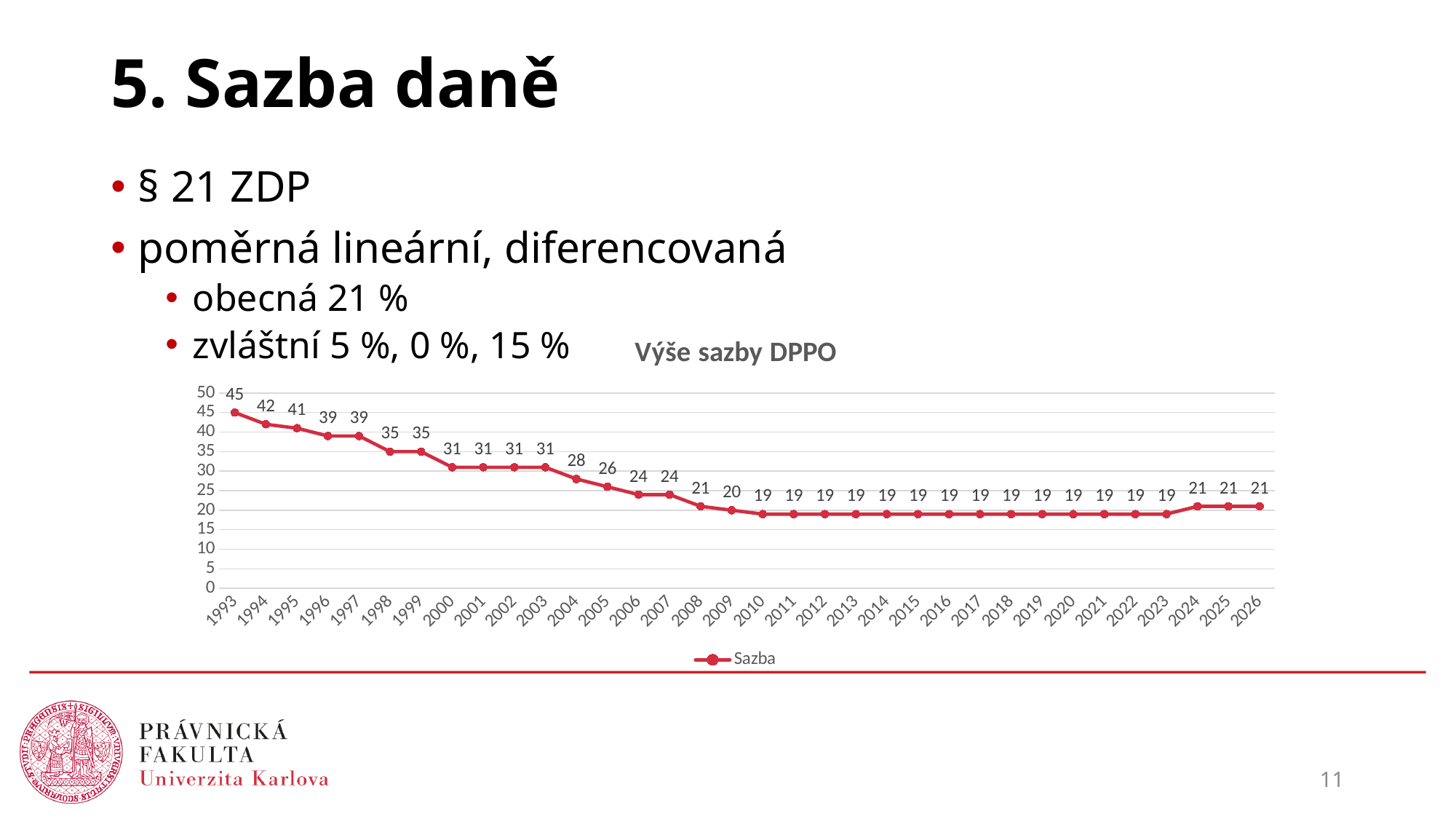
Which is larger, the value for 1998 or the value for 2005? 1998 How many data points are plotted in the chart? 34 What is the value for 2024 in the chart? 21 Do the values generally rise or fall from 1993 to 2023? fall What is the value for 2009 in the chart? 20 What is the value for 2004 in the chart? 28 What is the lowest value shown in the chart? 19 What is the difference between the values for 1993 and 2026? 24 What kind of chart is shown on the slide? line chart Which year has the highest value in the chart? 1993 What is the value for 1993 in the chart? 45 What is the title of the chart? Výše sazby DPPO